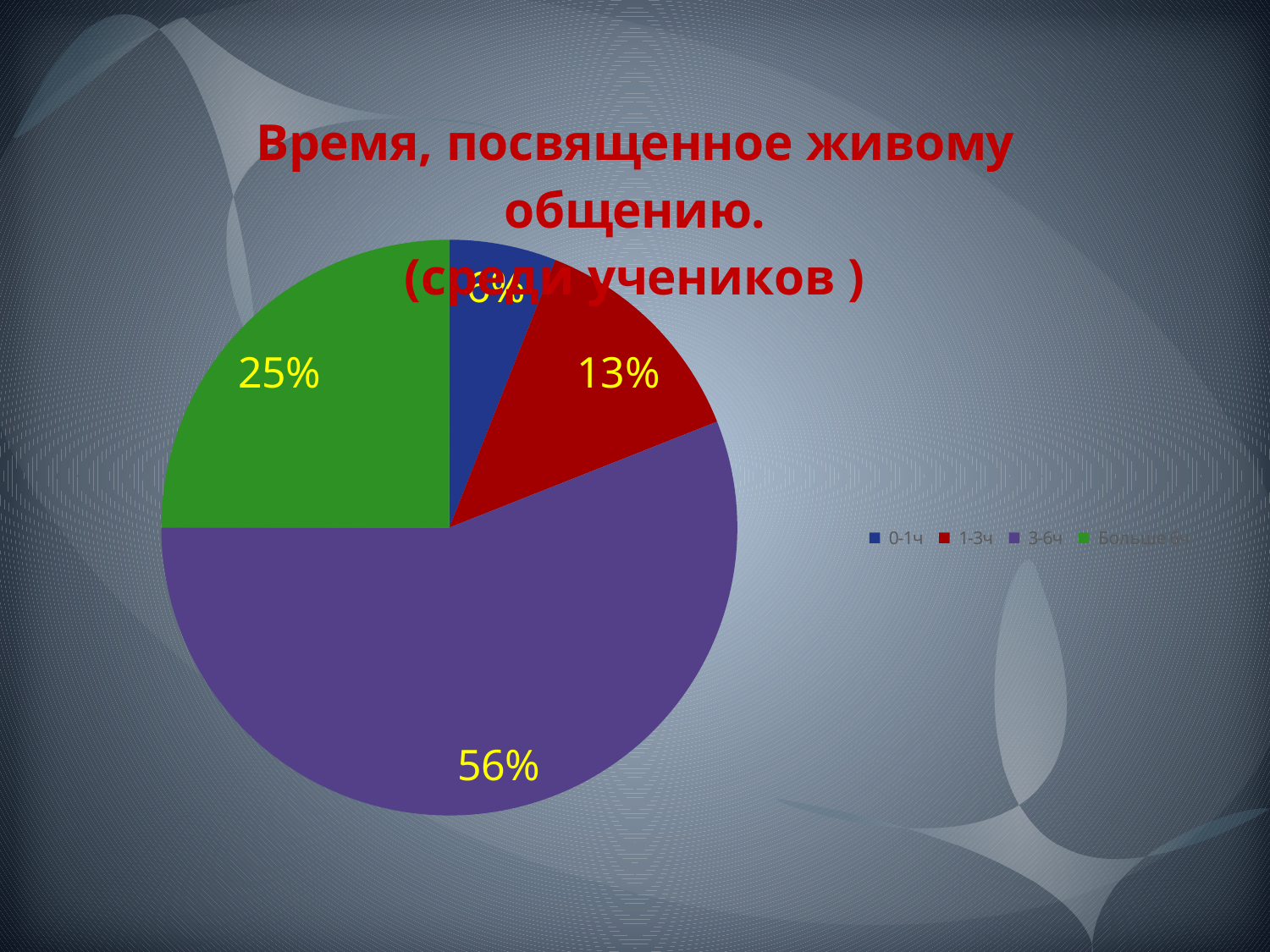
What is the difference in percentage points between the 3-6ч slice and the Больше 6ч slice? 31% What is the title of the chart? Время, посвященное живому общению. (среди учеников ) What colour is the 3-6ч slice? purple Which category has the smallest slice of the pie? 0-1ч Which slice is larger, 1-3ч or Больше 6ч? Больше 6ч What kind of chart is shown on the slide? pie chart How many categories does the pie chart have? 4 What share of the pie does the green slice (Больше 6ч) represent? 25% What share of the pie does the 1-3ч slice represent? 13% What share of the pie does the 3-6ч slice represent? 56% Which category has the largest slice of the pie? 3-6ч What is the difference in percentage points between the Больше 6ч slice and the 1-3ч slice? 12%